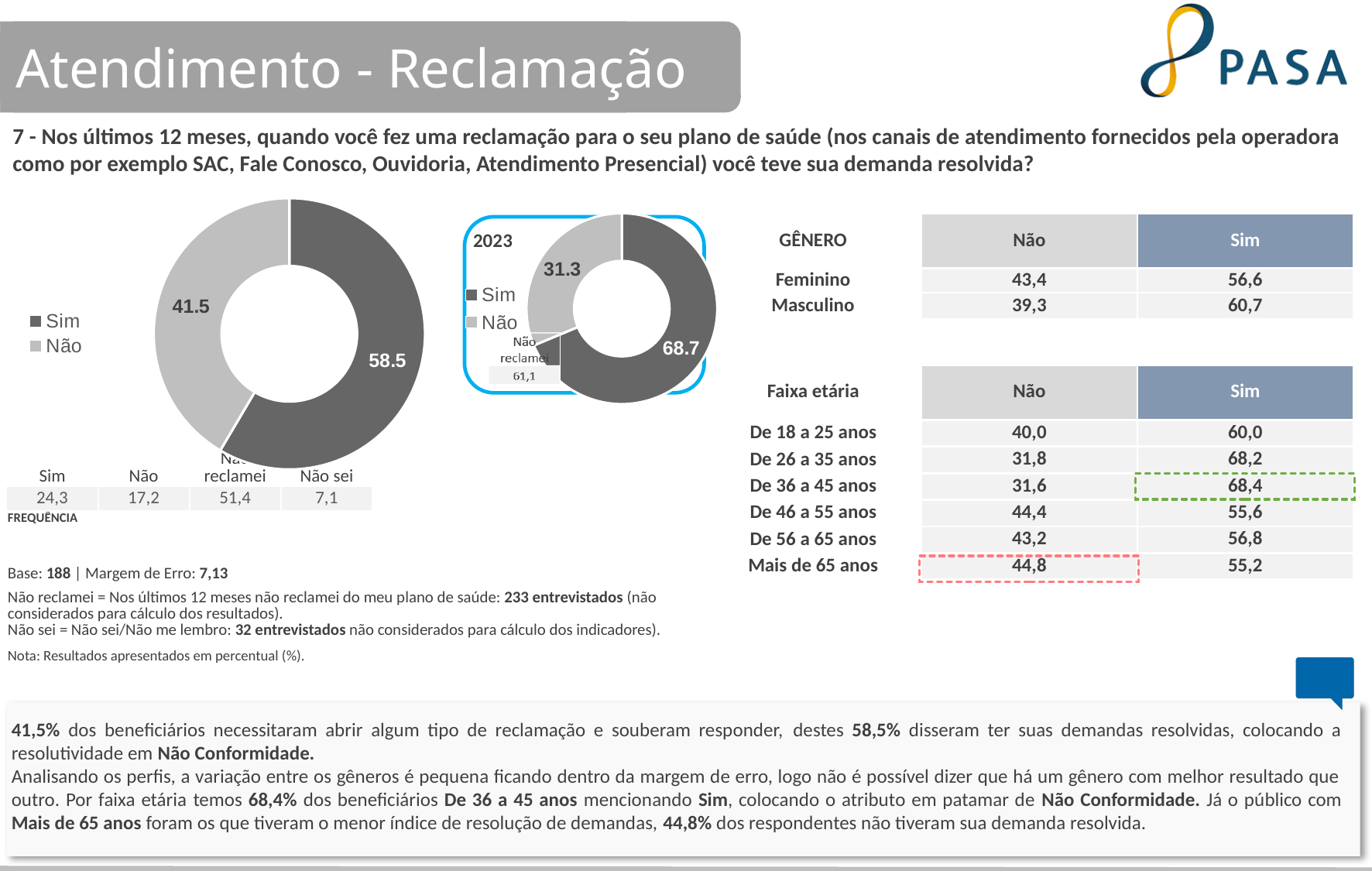
In the 2023 donut chart, what is the difference between the Sim and Não values? 37.4 Is the Sim value larger in the 2023 donut chart or in the large donut chart on the left? 2023 donut chart In the large donut chart on the left, what is the difference between the Sim and Não values? 17.0 In the 2023 donut chart, what is the value for Não? 31.3 In the 2023 donut chart, what is the value for Sim? 68.7 In the large donut chart on the left, how many slices are there? 2 In the large donut chart on the left, what is the value for Não? 41.5 What kind of chart is the large chart on the left? Donut (pie) chart In the large donut chart on the left, what is the value for Sim? 58.5 In the large donut chart on the left, which slice is larger, Sim or Não? Sim In the large donut chart on the left, how many entries does the legend list? 2 In the 2023 donut chart, which slice is the smallest? Não